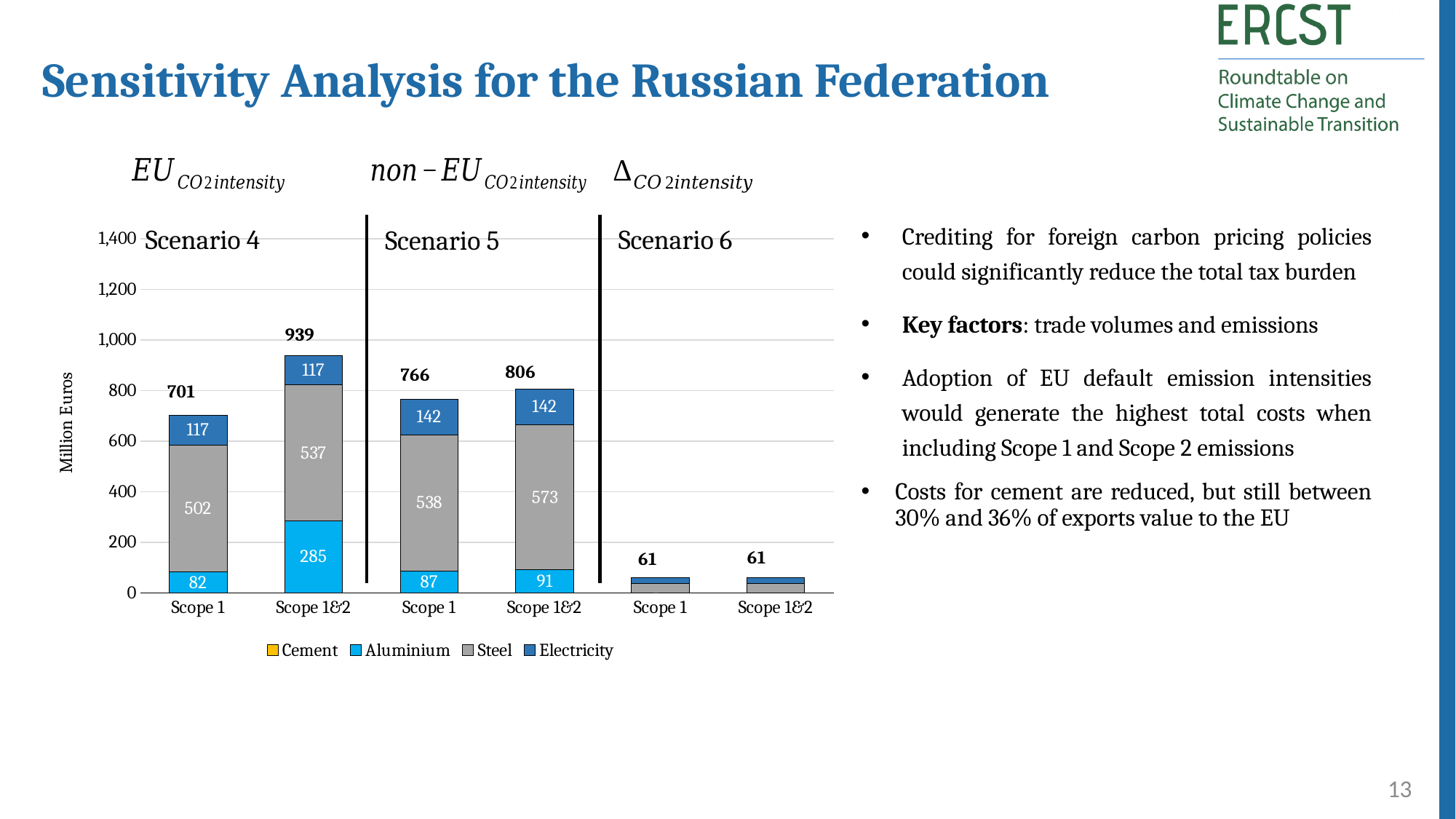
Is the Scope 1 total for Scenario 6 greater or less than 200? less What is the difference between the Scope 1&2 total and the Scope 1 total in Scenario 5? 40 What is the label of the vertical axis? Million Euros What type of chart is shown on the slide? Stacked bar chart What is the difference between the Scope 1&2 total for Scenario 4 and the Scope 1&2 total for Scenario 5? 133 Which is larger: the Scope 1 total for Scenario 4 or the Scope 1 total for Scenario 5? Scenario 5 Scope 1 What is the total value shown above the Scope 1&2 bar for Scenario 4? 939 What is the Electricity value in the Scope 1&2 bar for Scenario 5? 142 What is the Steel value in the Scope 1 bar for Scenario 5? 538 What is the Aluminium value in the Scope 1&2 bar for Scenario 4? 285 How many series does the legend list? 4 Which bar has the highest total value? Scenario 4 Scope 1&2